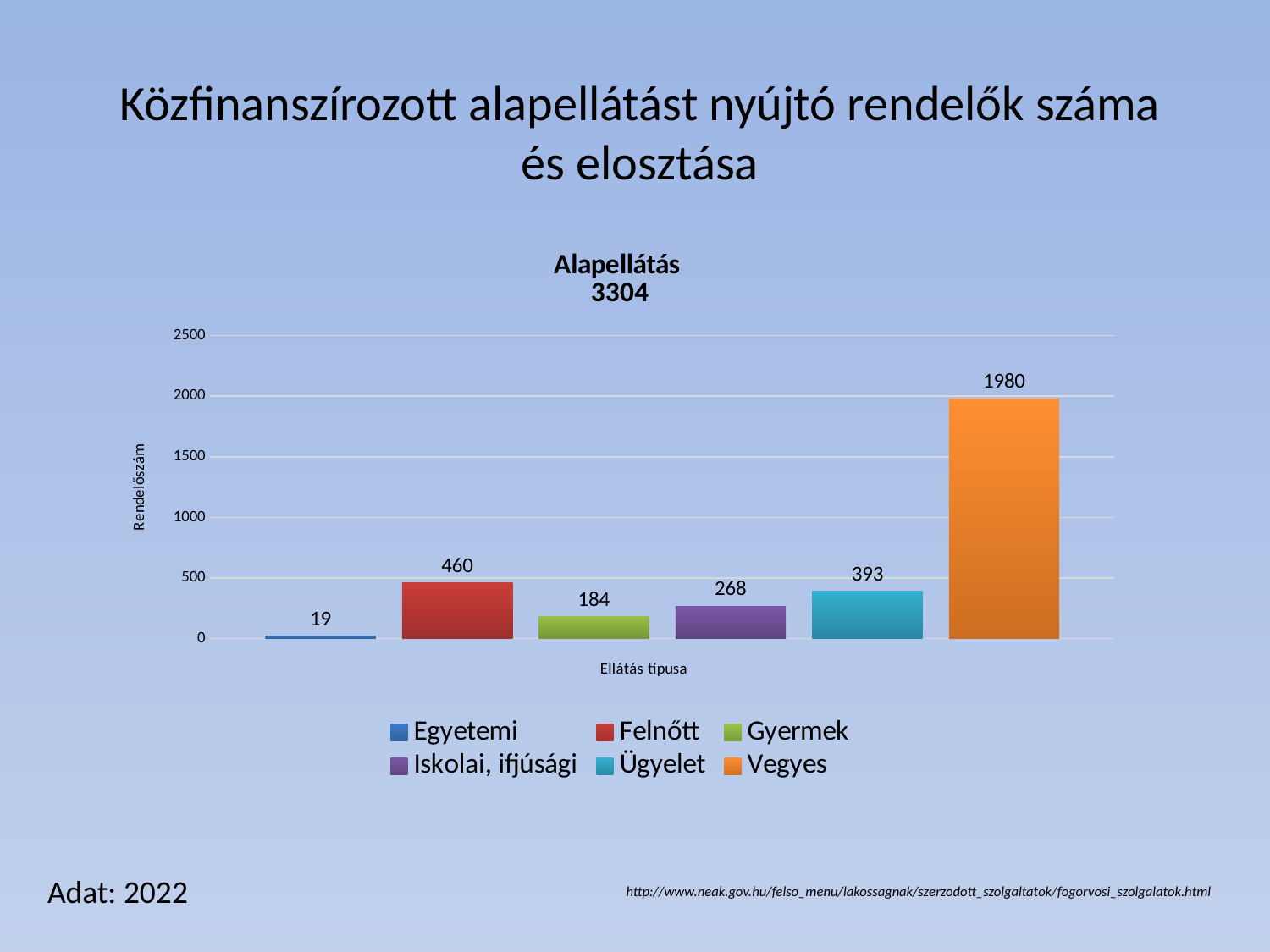
What is the difference between the values for Felnőtt and Gyermek? 276 What is the title of the chart? Alapellátás 3304 What is the value for Felnőtt? 460 What is the value for Vegyes? 1980 What is the value for Egyetemi? 19 What is the value for Ügyelet? 393 Which category has the highest value? Vegyes Which is larger, the value for Ügyelet or the value for Iskolai, ifjúsági? Ügyelet Is the value for Vegyes greater or less than 1500? greater Which category has the lowest value? Egyetemi How many categories are shown in the chart? 6 What kind of chart is shown on the slide? bar chart